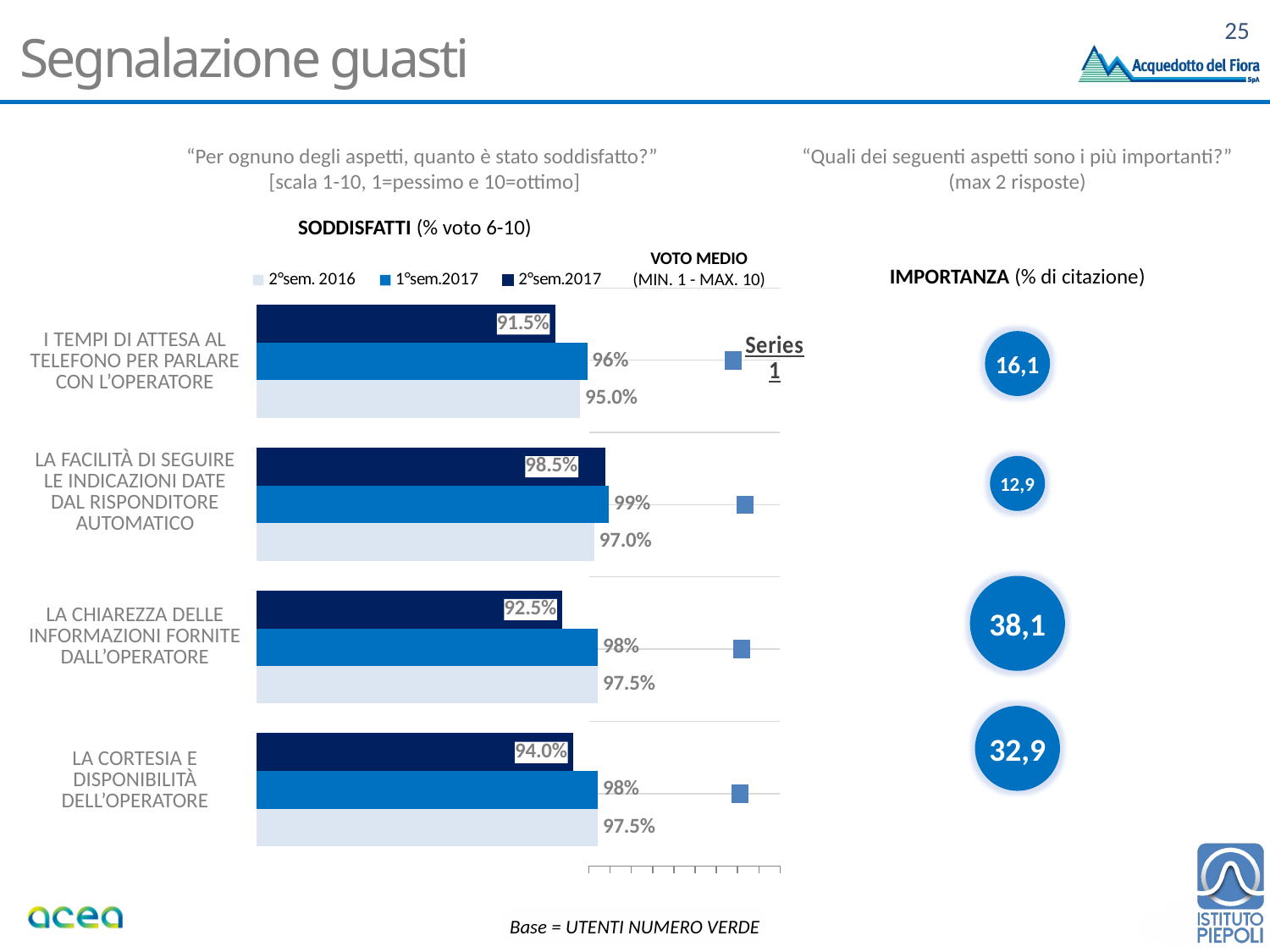
In the IMPORTANZA (% di citazione) chart, which category has the highest value? LA CHIAREZZA DELLE INFORMAZIONI FORNITE DALL'OPERATORE What kind of chart is the SODDISFATTI chart? Bar chart In the SODDISFATTI chart, what is the 2°sem.2017 value for LA CHIAREZZA DELLE INFORMAZIONI FORNITE DALL'OPERATORE? 92.5% In the SODDISFATTI chart, what is the 2°sem. 2016 value for LA CORTESIA E DISPONIBILITÀ DELL'OPERATORE? 97.5% In the SODDISFATTI chart, which category has the lowest 2°sem.2017 value? I TEMPI DI ATTESA AL TELEFONO PER PARLARE CON L'OPERATORE In the SODDISFATTI chart, for LA CORTESIA E DISPONIBILITÀ DELL'OPERATORE, which is larger: the 1°sem.2017 value or the 2°sem.2017 value? 1°sem.2017 How many categories are shown in the SODDISFATTI chart? 4 In the SODDISFATTI chart, what is the 1°sem.2017 value for I TEMPI DI ATTESA AL TELEFONO PER PARLARE CON L'OPERATORE? 96% In the SODDISFATTI chart, which category has the highest 2°sem.2017 value? LA FACILITÀ DI SEGUIRE LE INDICAZIONI DATE DAL RISPONDITORE AUTOMATICO How many series does the legend of the SODDISFATTI chart list? 3 In the SODDISFATTI chart, what is the difference between the 1°sem.2017 and 2°sem.2017 values for LA CHIAREZZA DELLE INFORMAZIONI FORNITE DALL'OPERATORE? 5.5% In the SODDISFATTI chart, what is the 2°sem.2017 value for LA FACILITÀ DI SEGUIRE LE INDICAZIONI DATE DAL RISPONDITORE AUTOMATICO? 98.5%